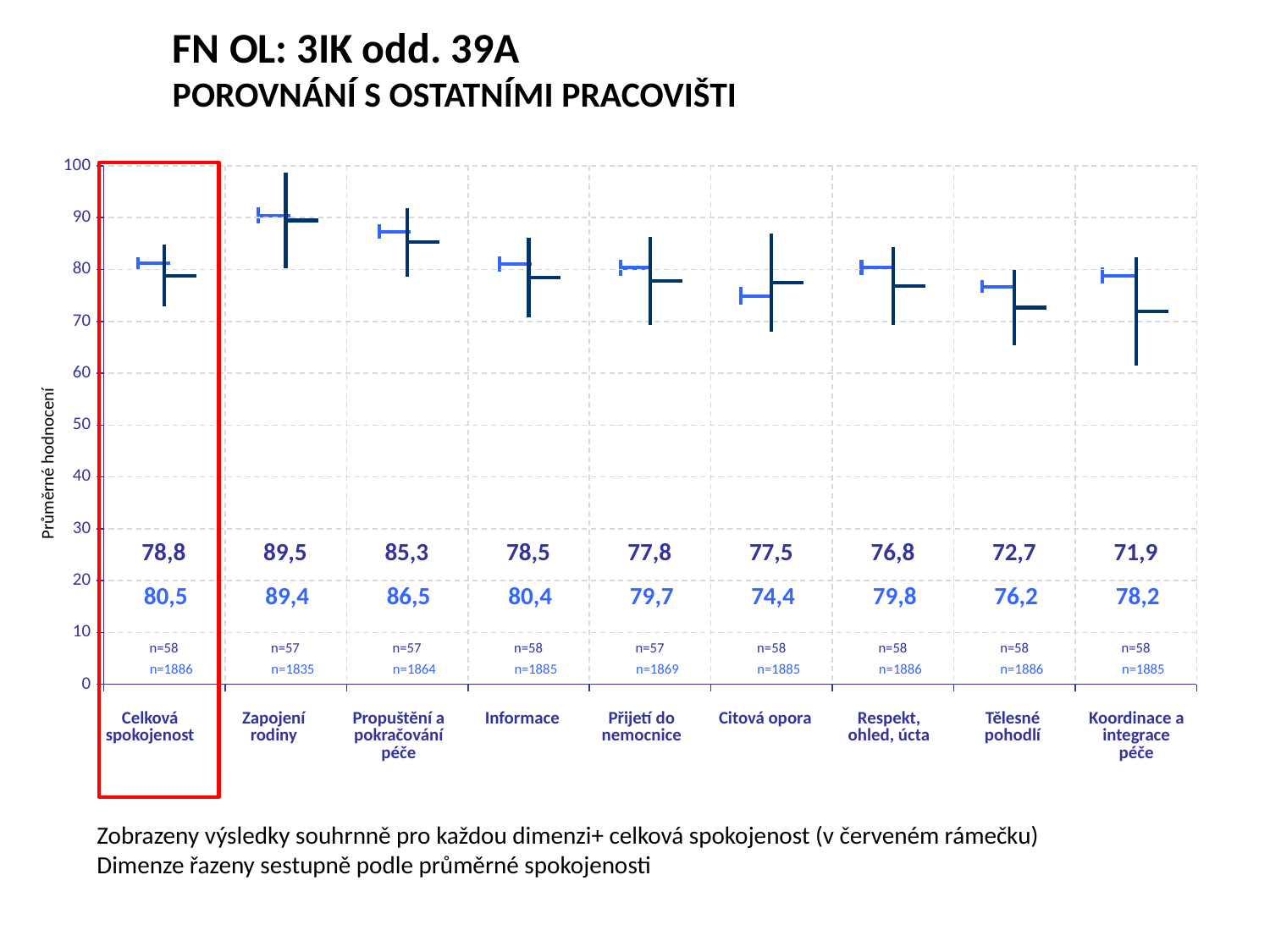
What is the dark blue (upper) value shown for Koordinace a integrace péče? 71,9 What is the light blue (lower) value shown for Celková spokojenost? 80,5 What is the dark blue (upper) value shown for Zapojení rodiny? 89,5 Which is larger for Tělesné pohodlí: the dark blue (upper) value or the light blue (lower) value? the light blue (lower) value, 76,2 What is the difference between the light blue and dark blue values for Koordinace a integrace péče? 6,3 What is the light blue (lower) value shown for Citová opora? 74,4 Which category has the highest dark blue (upper) value? Zapojení rodiny What is the n value printed in dark blue for Zapojení rodiny? n=57 Which category has the lowest dark blue (upper) value? Koordinace a integrace péče What is the label of the vertical axis of the chart? Průměrné hodnocení How many categories are shown on the x axis of the chart? 9 What is the dark blue (upper) value shown for Celková spokojenost? 78,8